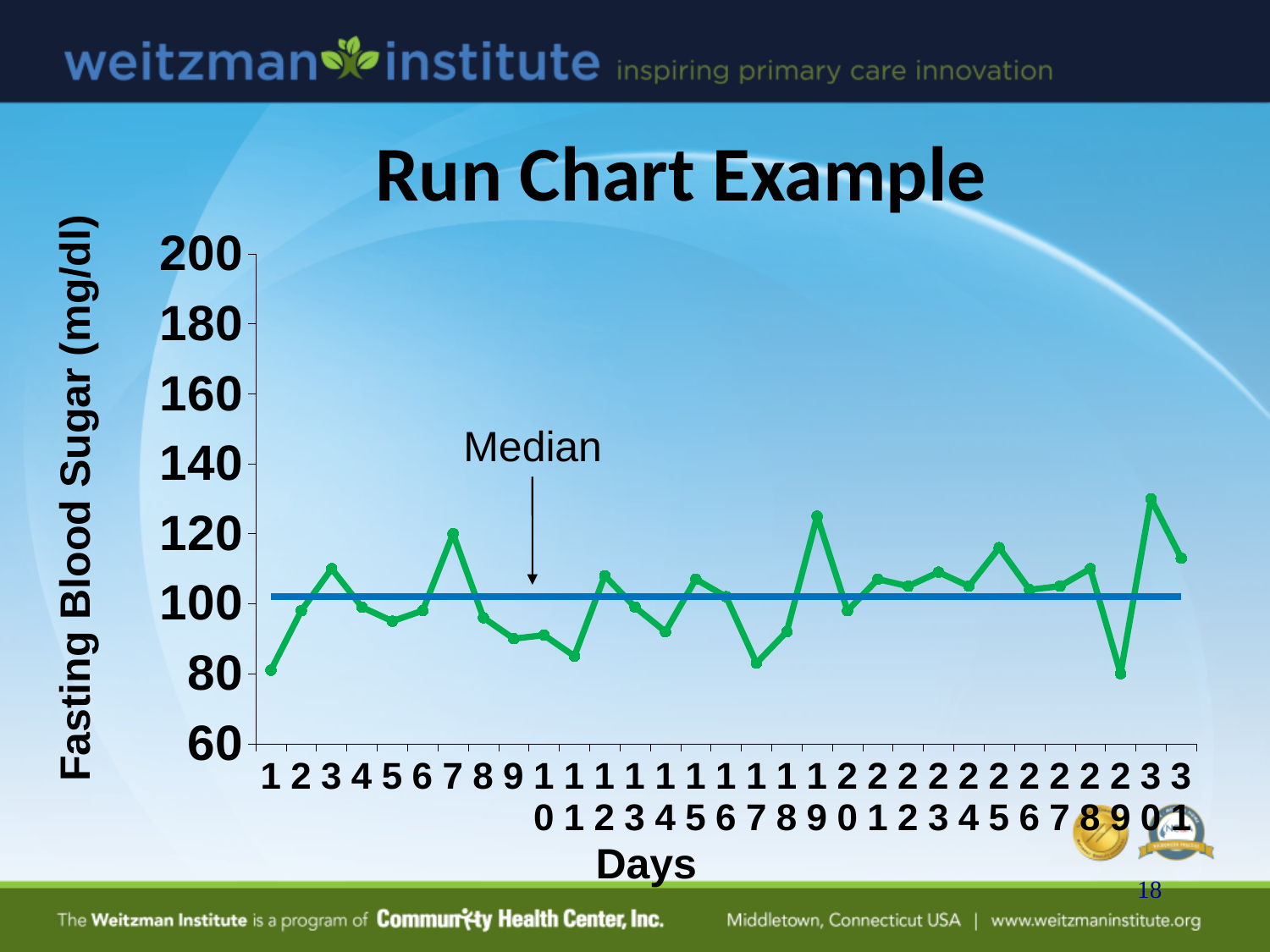
What is the title of the chart? Run Chart Example Is the value for day 29 greater or less than 100? less How many days are plotted on the x axis? 31 What kind of chart is shown on the slide? line chart Is the value for day 17 greater or less than 100? less What is the label of the vertical axis? Fasting Blood Sugar (mg/dl) Is the value for day 19 greater or less than 120? greater On which day is the fasting blood sugar highest? 30 Which has the higher fasting blood sugar, day 30 or day 29? day 30 Which has the higher fasting blood sugar, day 7 or day 11? day 7